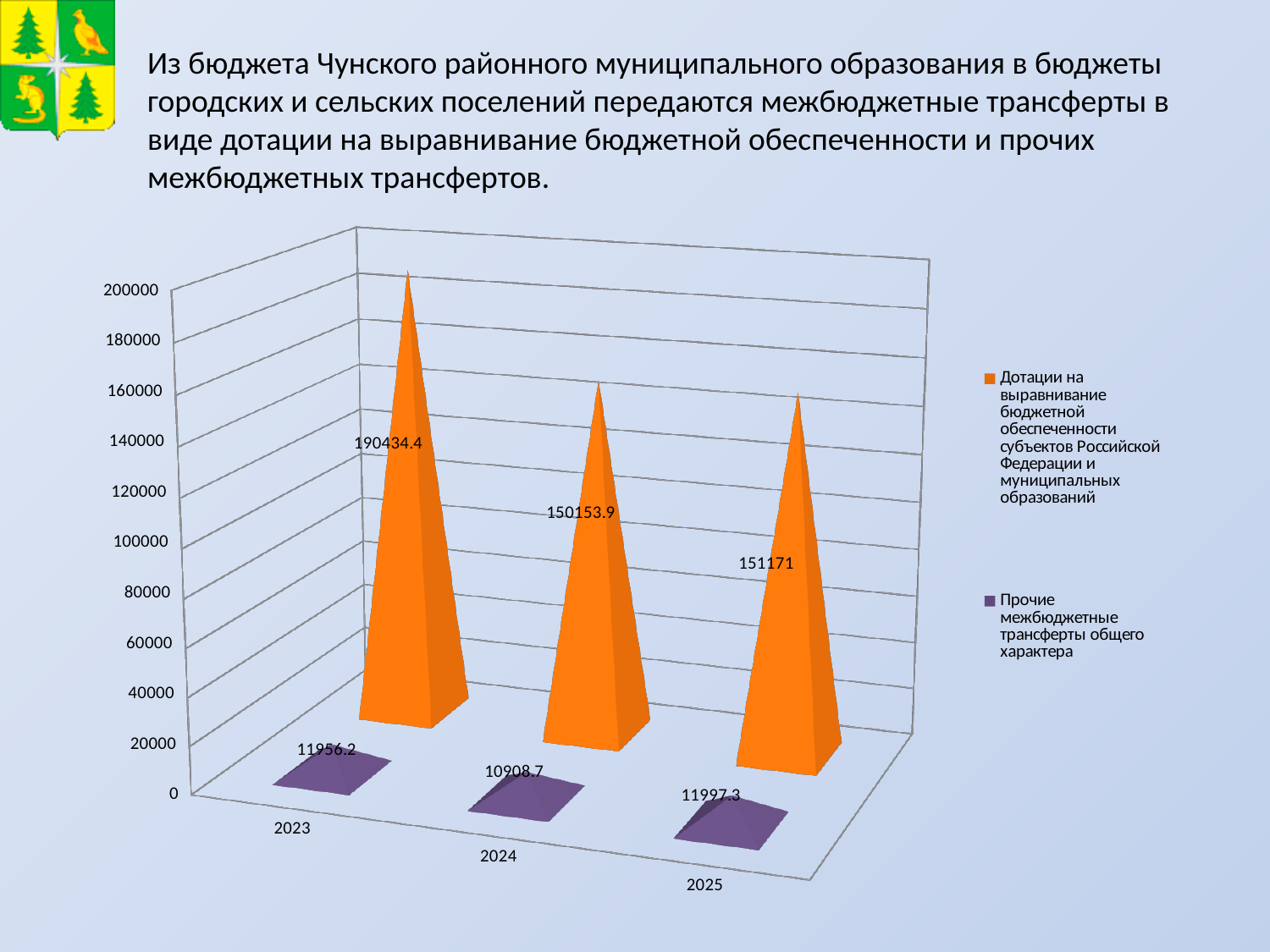
What colour represents the 'Прочие межбюджетные трансферты общего характера' series? Purple What is the difference between the 'Прочие межбюджетные трансферты общего характера' values for 2025 and 2024? 1088.6 What is the value of the 'Прочие межбюджетные трансферты общего характера' series for 2025? 11997.3 Which year has the larger 'Дотации на выравнивание бюджетной обеспеченности' value, 2024 or 2025? 2025 What is the difference between the 'Дотации на выравнивание бюджетной обеспеченности' values for 2023 and 2024? 40280.5 In which year is the 'Дотации на выравнивание бюджетной обеспеченности' value the highest? 2023 What is the value of the 'Дотации на выравнивание бюджетной обеспеченности' series for 2023? 190434.4 In which year is the 'Прочие межбюджетные трансферты общего характера' value the lowest? 2024 What is the value of the 'Дотации на выравнивание бюджетной обеспеченности' series for 2025? 151171 How many series does the chart legend list? 2 How many years are shown on the x axis of the chart? 3 What is the value of the 'Прочие межбюджетные трансферты общего характера' series for 2024? 10908.7